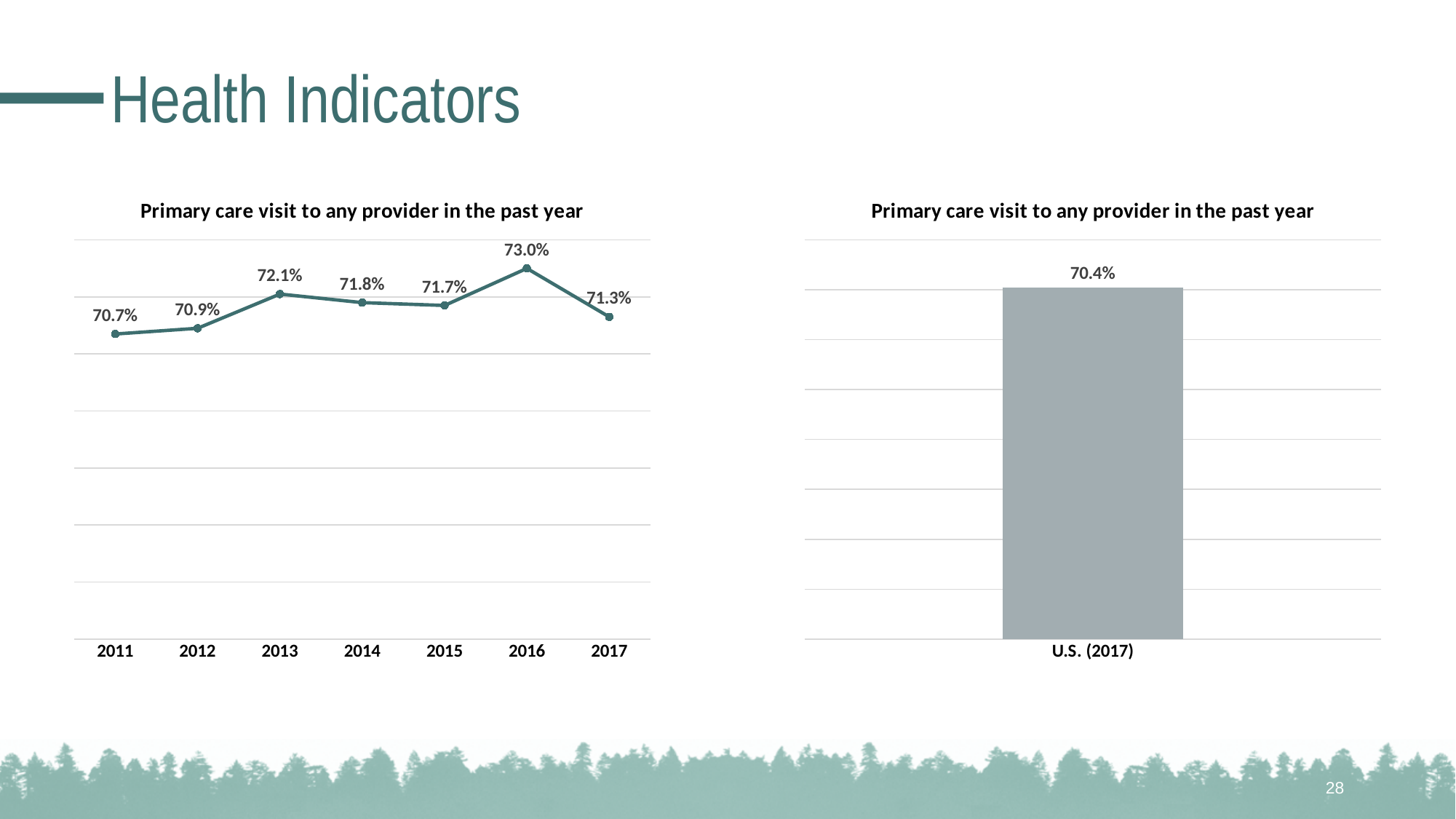
In the left line chart, what is the difference between the 2016 value and the 2011 value? 2.3% In the left line chart, which year has the lowest value? 2011 In the left line chart, which is larger, the value for 2013 or the value for 2017? 2013 How many years are plotted in the left line chart? 7 In the left line chart, which year has the highest value? 2016 In the left line chart, does the value rise or fall from 2016 to 2017? fall In the left line chart, what is the value for 2011? 70.7% In the left line chart, what is the value for 2016? 73.0% What kind of chart is the chart on the right side of the slide? bar chart In the right bar chart, what is the value for U.S. (2017)? 70.4% What is the title of the chart on the left side of the slide? Primary care visit to any provider in the past year In the left line chart, what is the value for 2014? 71.8%